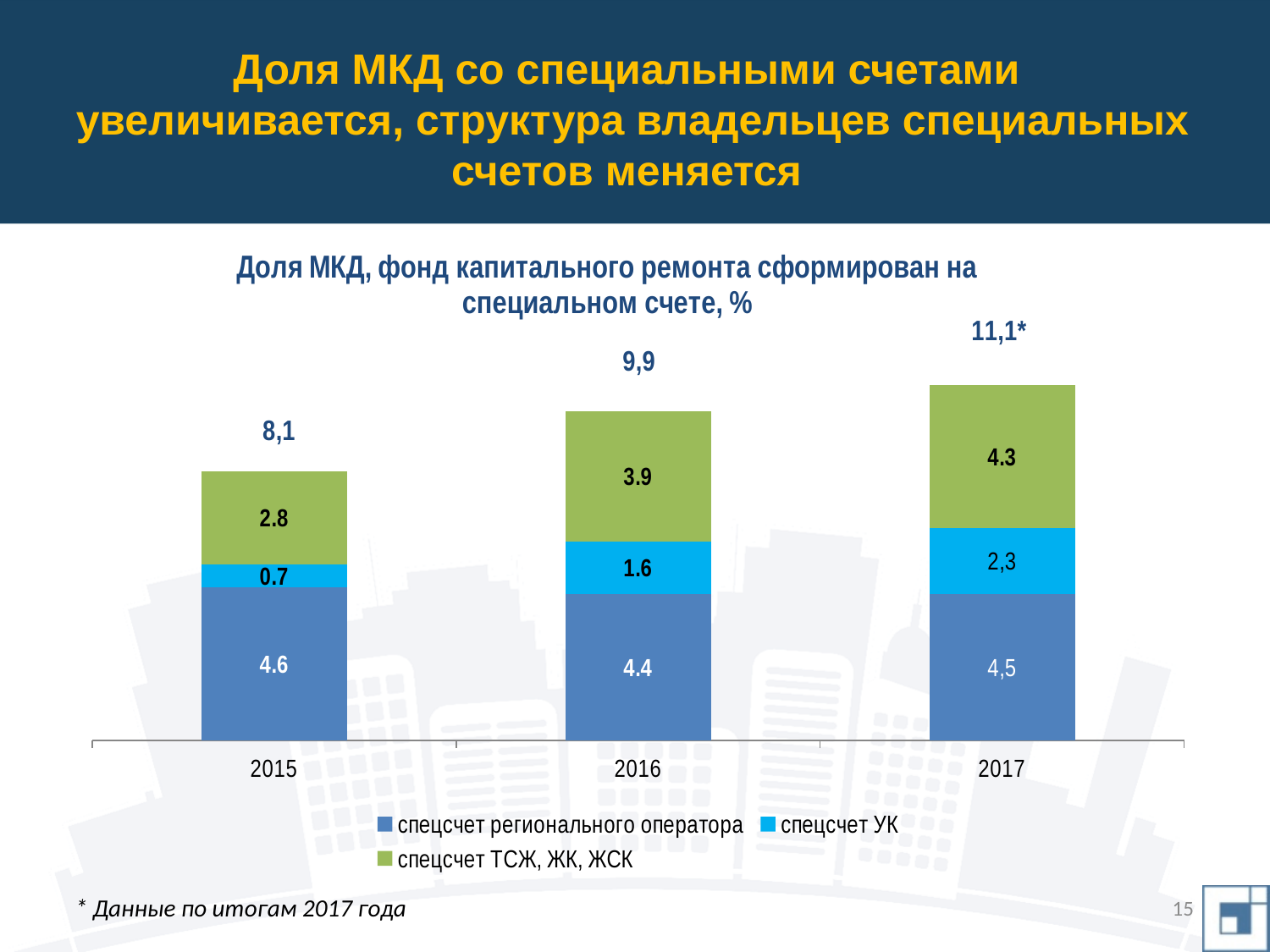
What is the value for 'спецсчет регионального оператора' in 2015? 4.6 What is the total printed above the 2016 bar? 9,9 How many years (categories) are shown on the x axis? 3 What is the value for 'спецсчет ТСЖ, ЖК, ЖСК' in 2017? 4.3 How many series does the legend list? 3 Which is larger in 2016: 'спецсчет регионального оператора' or 'спецсчет ТСЖ, ЖК, ЖСК'? спецсчет регионального оператора What is the total printed above the 2017 bar? 11,1* What is the value for 'спецсчет УК' in 2016? 1.6 Which year has the lowest value for 'спецсчет УК'? 2015 What type of chart is shown on the slide? stacked bar chart Does the total share rise or fall from 2015 to 2017? rises Which year has the highest total share of MKD with special accounts? 2017